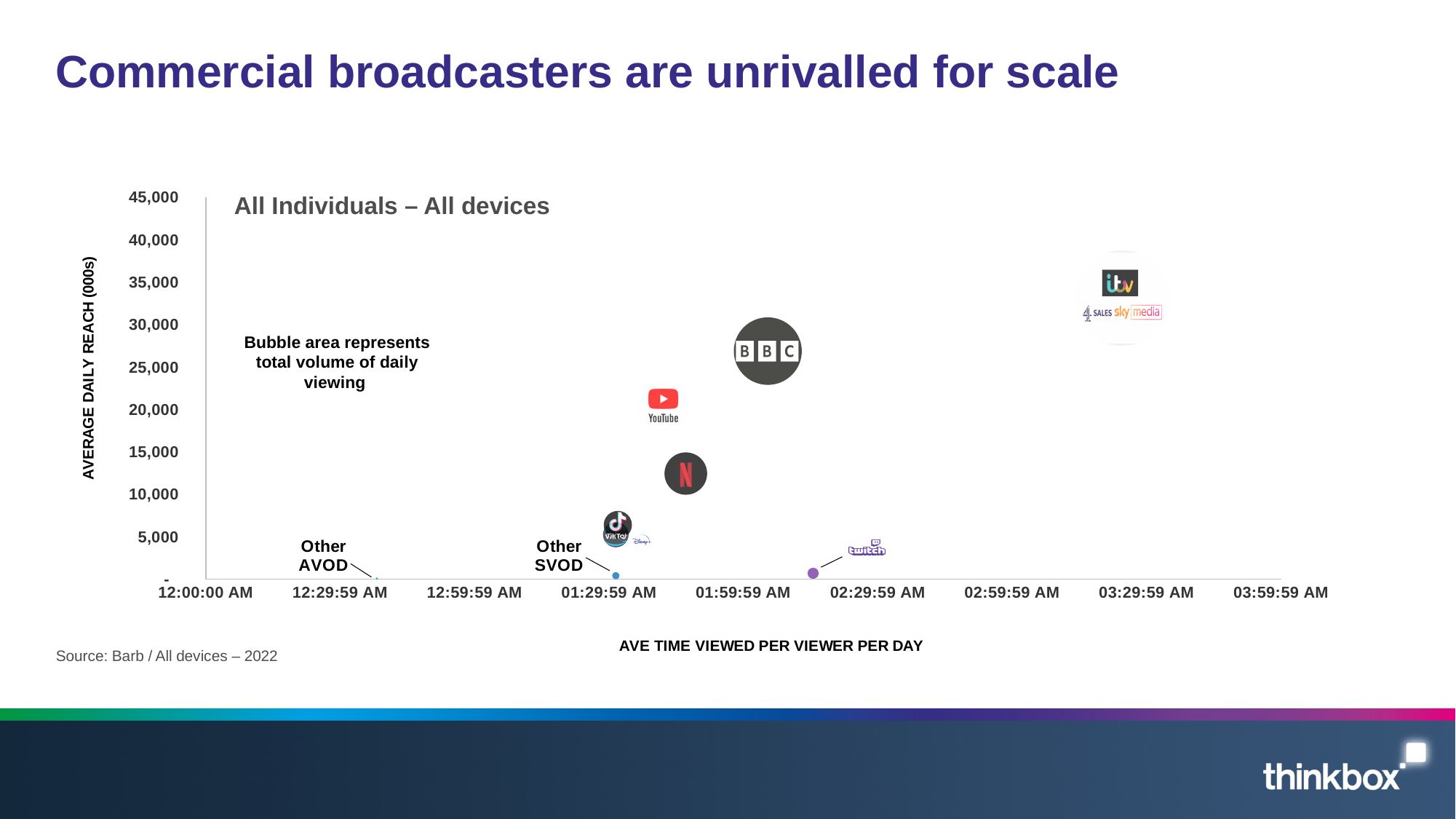
Is the average daily reach for Netflix greater or less than 10,000? greater Is the average daily reach for Netflix greater or less than 15,000? less Is the average daily reach for BBC greater or less than 25,000? greater Which has the higher average daily reach, BBC or YouTube? BBC What does the y axis of the chart measure? AVERAGE DAILY REACH (000s) What kind of chart is shown on the slide? bubble chart Which bubble has the highest average daily reach? the commercial broadcasters (ITV, 4 Sales, Sky Media) Which has the longer average time viewed per viewer per day, BBC or Netflix? BBC Which has the higher average daily reach, Netflix or TikTok? Netflix What is the title shown inside the chart area? All Individuals – All devices